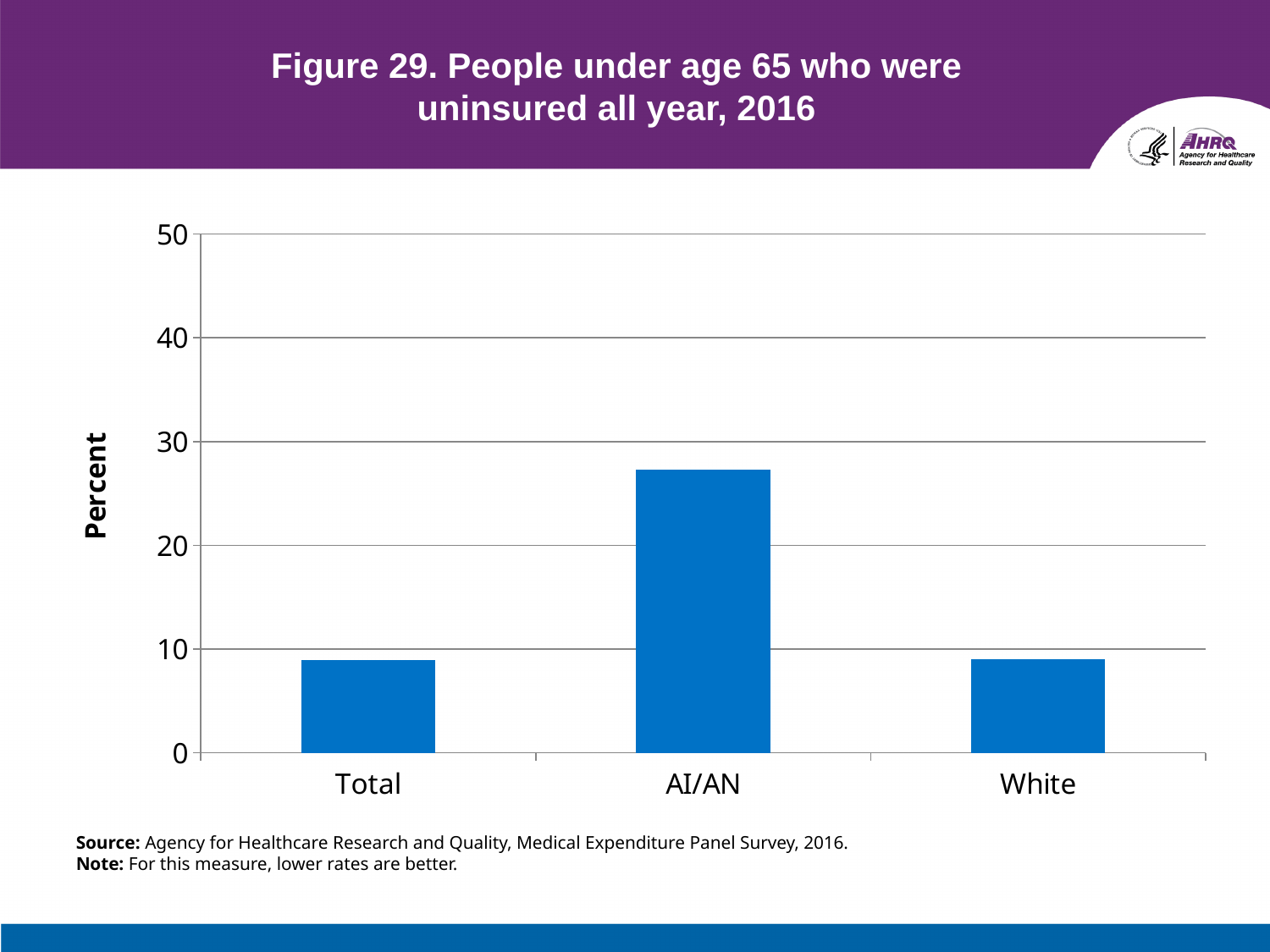
Which is larger, the value for AI/AN or the value for White? AI/AN Which is larger, the value for Total or the value for AI/AN? AI/AN Is the value for AI/AN greater or less than 30? less What is the label on the vertical axis of the chart? Percent Is the value for White greater or less than 10? less How many categories are shown on the x axis of the chart? 3 Is the value for AI/AN greater or less than 20? greater What is the title of the chart on the slide? Figure 29. People under age 65 who were uninsured all year, 2016 What is the highest value shown on the vertical axis of the chart? 50 What kind of chart is shown on the slide? bar chart Which category has the highest value in the chart? AI/AN